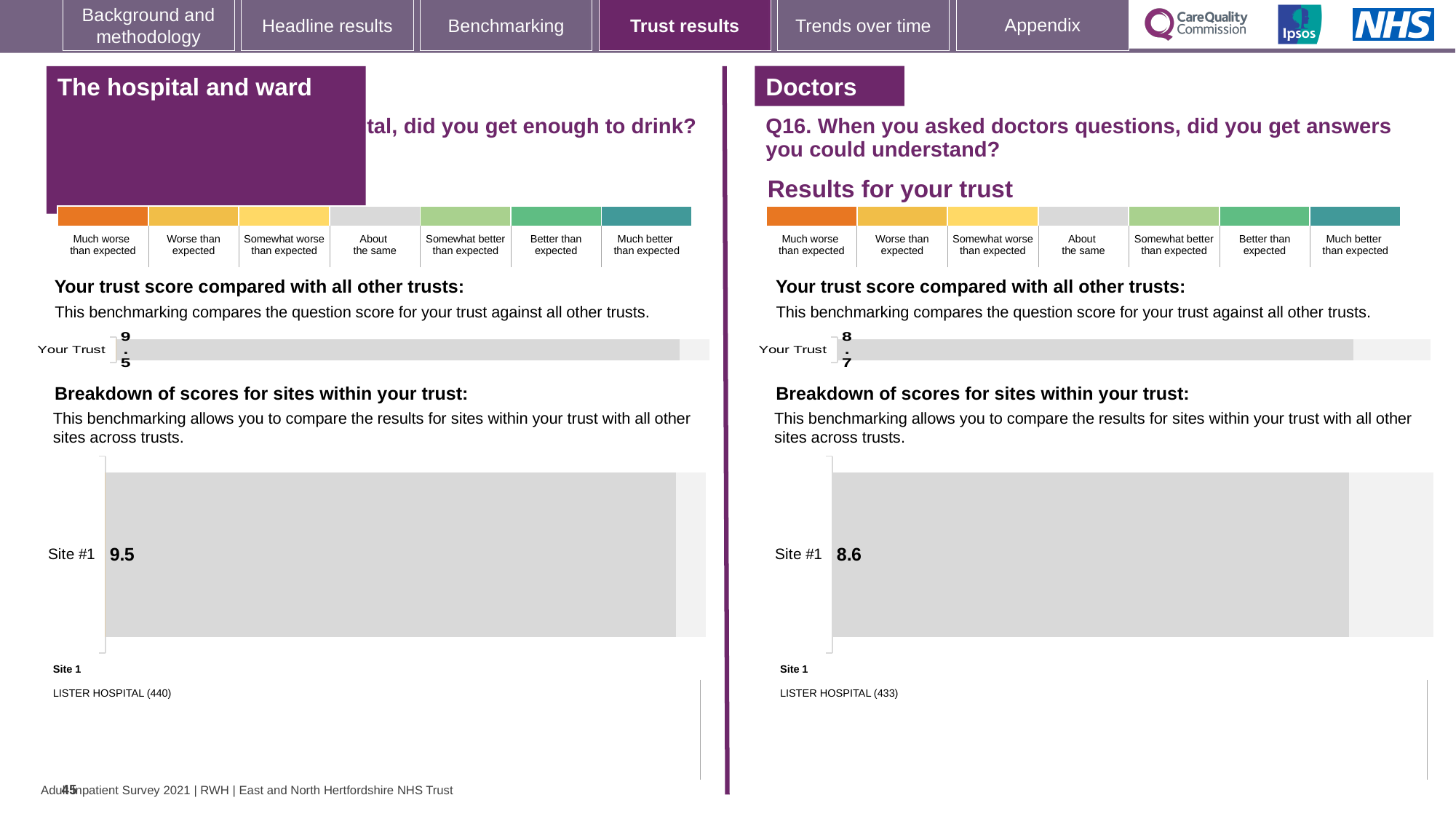
Comparing the Site #1 bars, which breakdown chart shows the higher score: the left-hand or the right-hand (Doctors, Q16)? The left-hand In the left-hand breakdown chart, which hospital is listed as Site 1 below the chart? LISTER HOSPITAL (440) How many sites are shown in the left-hand 'Breakdown of scores for sites within your trust' chart? 1 In the left-hand 'Breakdown of scores for sites within your trust' chart, what is the score for Site #1? 9.5 What is the difference between the Site #1 score in the left-hand breakdown chart and the Site #1 score in the right-hand (Doctors, Q16) breakdown chart? 0.9 Comparing the two 'Your Trust' charts, which section has the higher trust score: the left-hand (The hospital and ward) or the right-hand (Doctors, Q16)? The left-hand (The hospital and ward) In the right-hand Doctors (Q16) section, what is the difference between the Your Trust score and the Site #1 score? 0.1 In the left-hand 'Your trust score compared with all other trusts' chart (The hospital and ward section), what is the score shown for Your Trust? 9.5 In the right-hand 'Breakdown of scores for sites within your trust' chart (Doctors, Q16), what is the score for Site #1? 8.6 What type of chart is used to show the Site #1 score in the right-hand (Doctors, Q16) breakdown? Bar chart In the right-hand 'Your trust score compared with all other trusts' chart (Doctors, Q16), what is the score shown for Your Trust? 8.7 What is the difference between the Your Trust score in the left-hand chart and the Your Trust score in the right-hand (Doctors, Q16) chart? 0.8